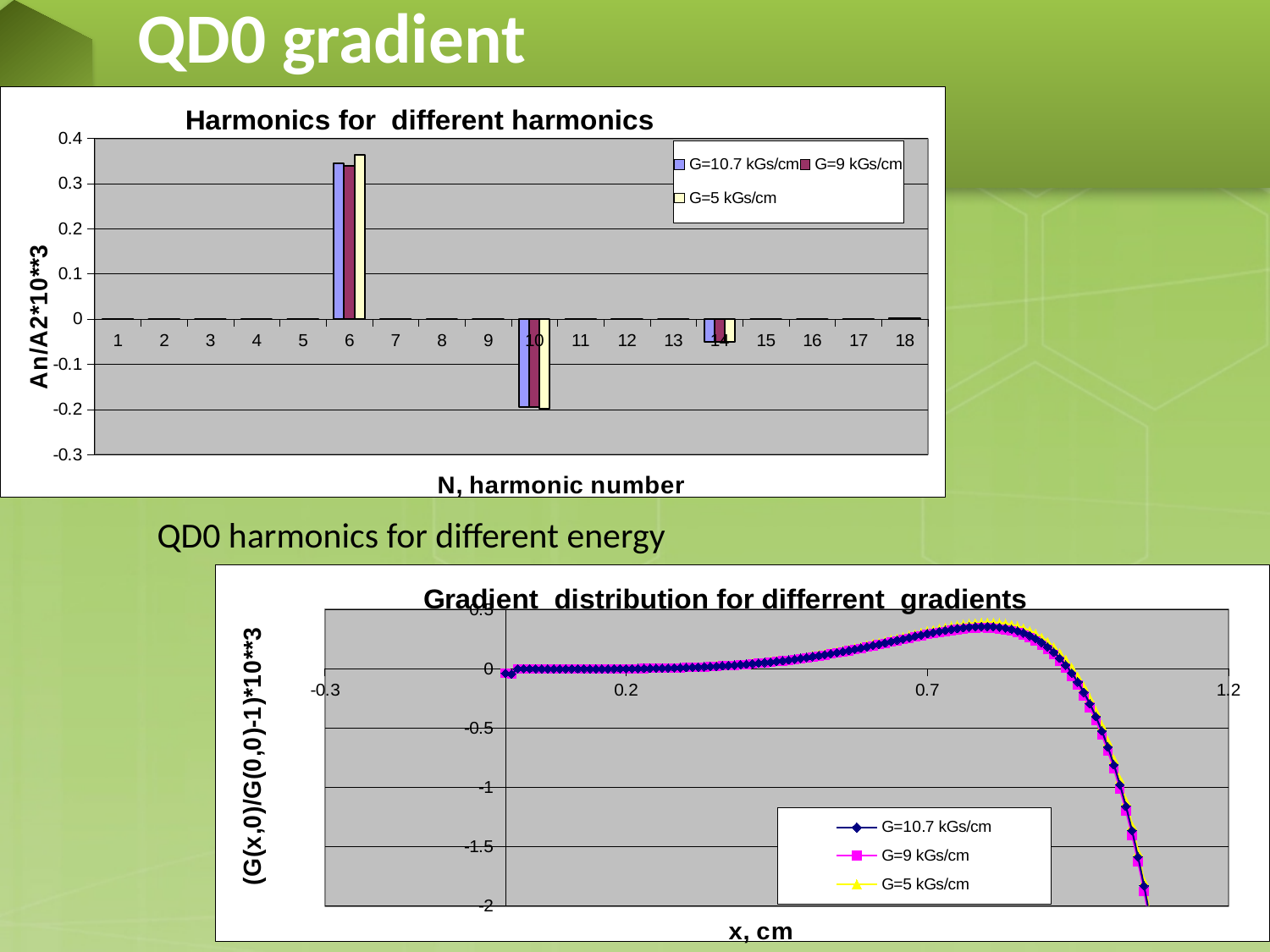
In the top chart "Harmonics for different harmonics", for G=9 kGs/cm, which is larger: the value at harmonic 10 or at harmonic 14? harmonic 14 In the top chart "Harmonics for different harmonics", which harmonic number has the lowest value? 10 In the top chart "Harmonics for different harmonics", is the value for harmonic 10 for G=5 kGs/cm greater or less than -0.1? less In the top chart "Harmonics for different harmonics", how many series does the legend list? 3 In the bottom chart "Gradient distribution for differrent gradients", what is the x-axis title? x, cm In the top chart "Harmonics for different harmonics", which harmonic number has the highest value? 6 In the bottom chart "Gradient distribution for differrent gradients", do the values rise or fall as x increases from 0.7 toward 1.2? fall What type of chart is the bottom chart titled "Gradient distribution for differrent gradients"? line chart What type of chart is the top chart titled "Harmonics for different harmonics"? bar chart In the bottom chart "Gradient distribution for differrent gradients", how many series does the legend list? 3 In the top chart "Harmonics for different harmonics", is the value for harmonic 6 for G=10.7 kGs/cm greater or less than 0.3? greater In the top chart "Harmonics for different harmonics", how many harmonic numbers are shown on the x axis? 18